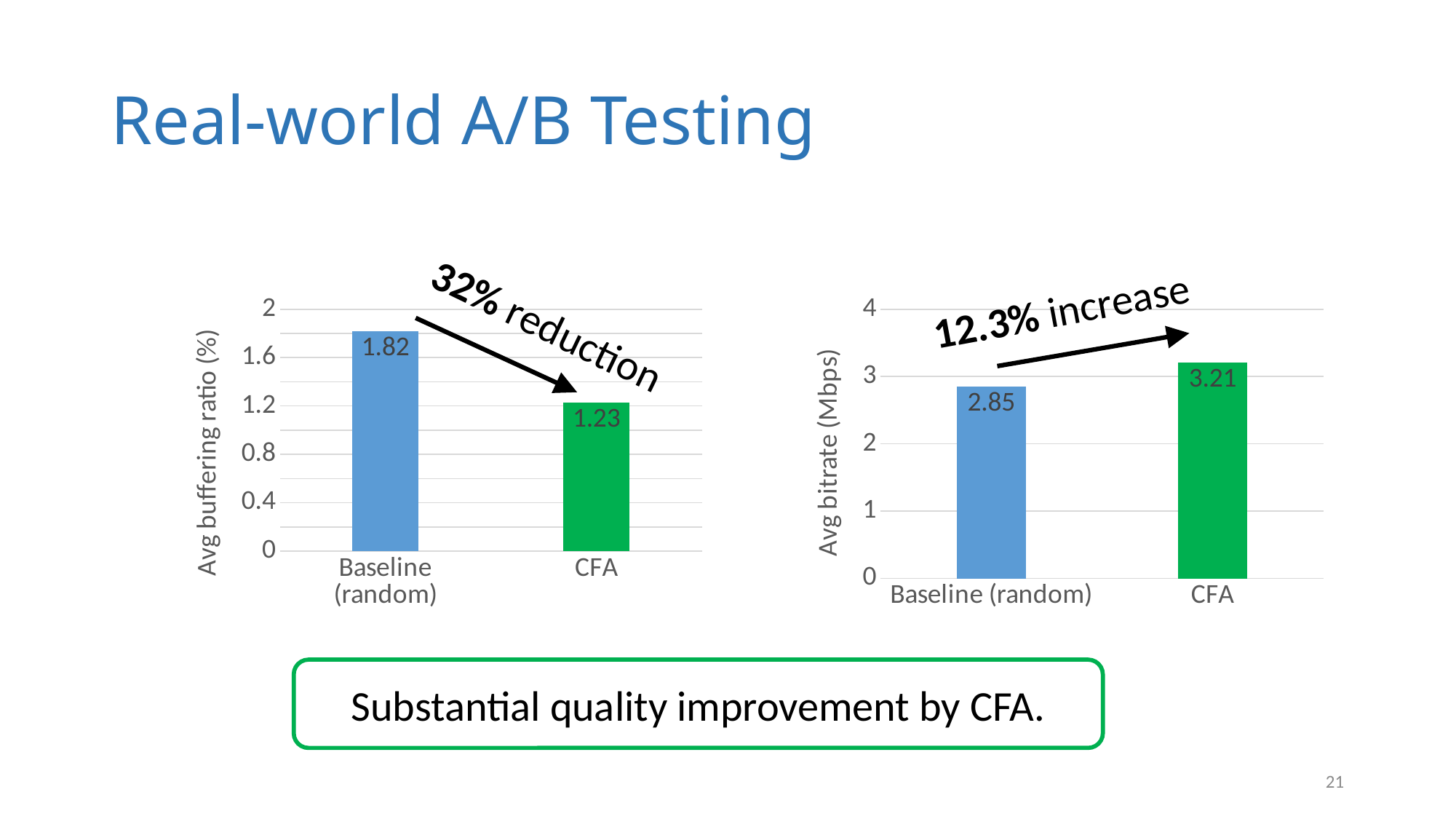
In the right chart (Avg bitrate), what is the difference between the CFA and Baseline (random) values? 0.36 In the left chart (Avg buffering ratio), what is the value for CFA? 1.23 In the right chart (Avg bitrate), which is larger, Baseline (random) or CFA? CFA What is the y-axis label of the right chart? Avg bitrate (Mbps) How many categories are shown in the left chart (Avg buffering ratio)? 2 In the right chart (Avg bitrate), what is the value for CFA? 3.21 In the left chart (Avg buffering ratio), which category has the lowest value? CFA In the left chart (Avg buffering ratio), what is the value for Baseline (random)? 1.82 In the right chart (Avg bitrate), what is the value for Baseline (random)? 2.85 In the right chart (Avg bitrate), which category has the highest value? CFA What type of chart is the right chart (Avg bitrate)? Bar chart In the left chart (Avg buffering ratio), what is the difference between the Baseline (random) and CFA values? 0.59